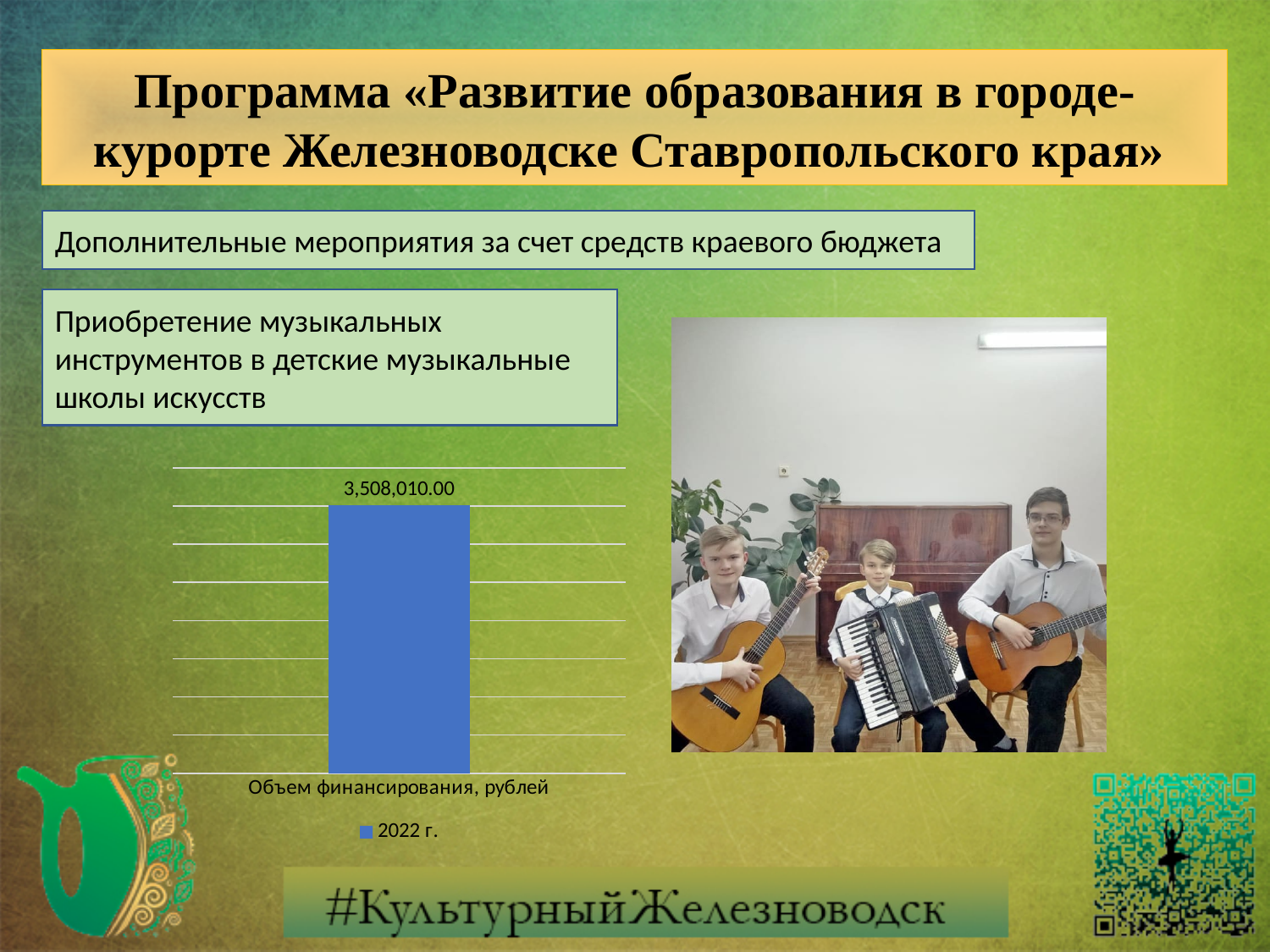
What series name appears in the chart legend? 2022 г. What kind of chart is shown on the slide? bar chart What is the value of the 2022 г. bar in the chart? 3,508,010.00 How many bars are plotted in the chart? 1 How many series does the chart legend list? 1 What is the value shown for "Объем финансирования, рублей" in the chart? 3,508,010.00 What is the category label shown under the bar in the chart? Объем финансирования, рублей